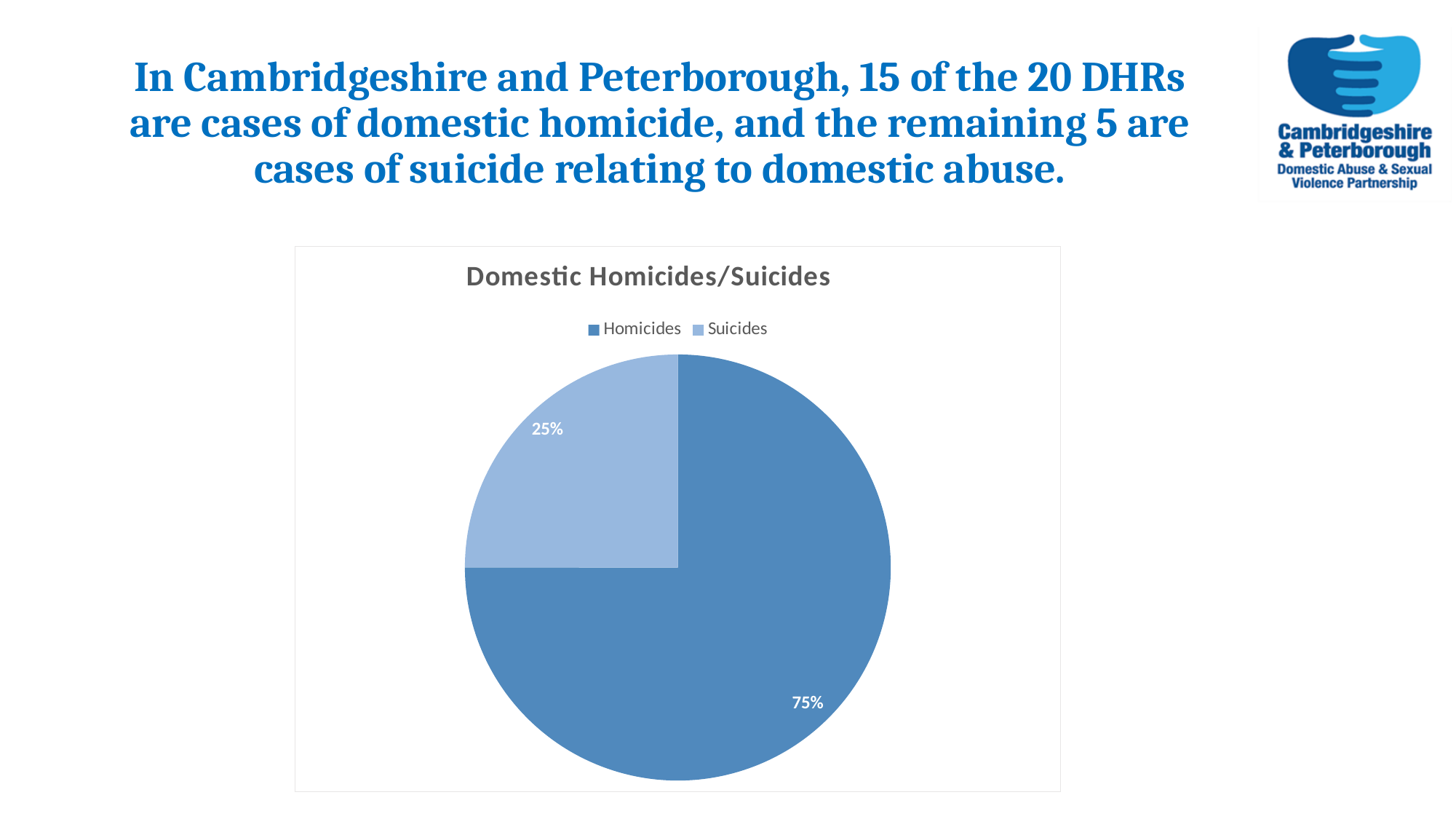
How many entries does the legend list? 2 What share of the pie does the Homicides slice represent? 75% How many slices does the pie chart have? 2 Which slice of the pie is the largest? Homicides What is the difference in percentage points between the Homicides and Suicides slices? 50% Which slice of the pie is the smallest? Suicides Which legend entry is shown in the lighter blue colour? Suicides Which is larger, the Homicides slice or the Suicides slice? Homicides What share of the pie does the Suicides slice represent? 25% What kind of chart is shown on the slide? Pie chart What is the title of the chart? Domestic Homicides/Suicides